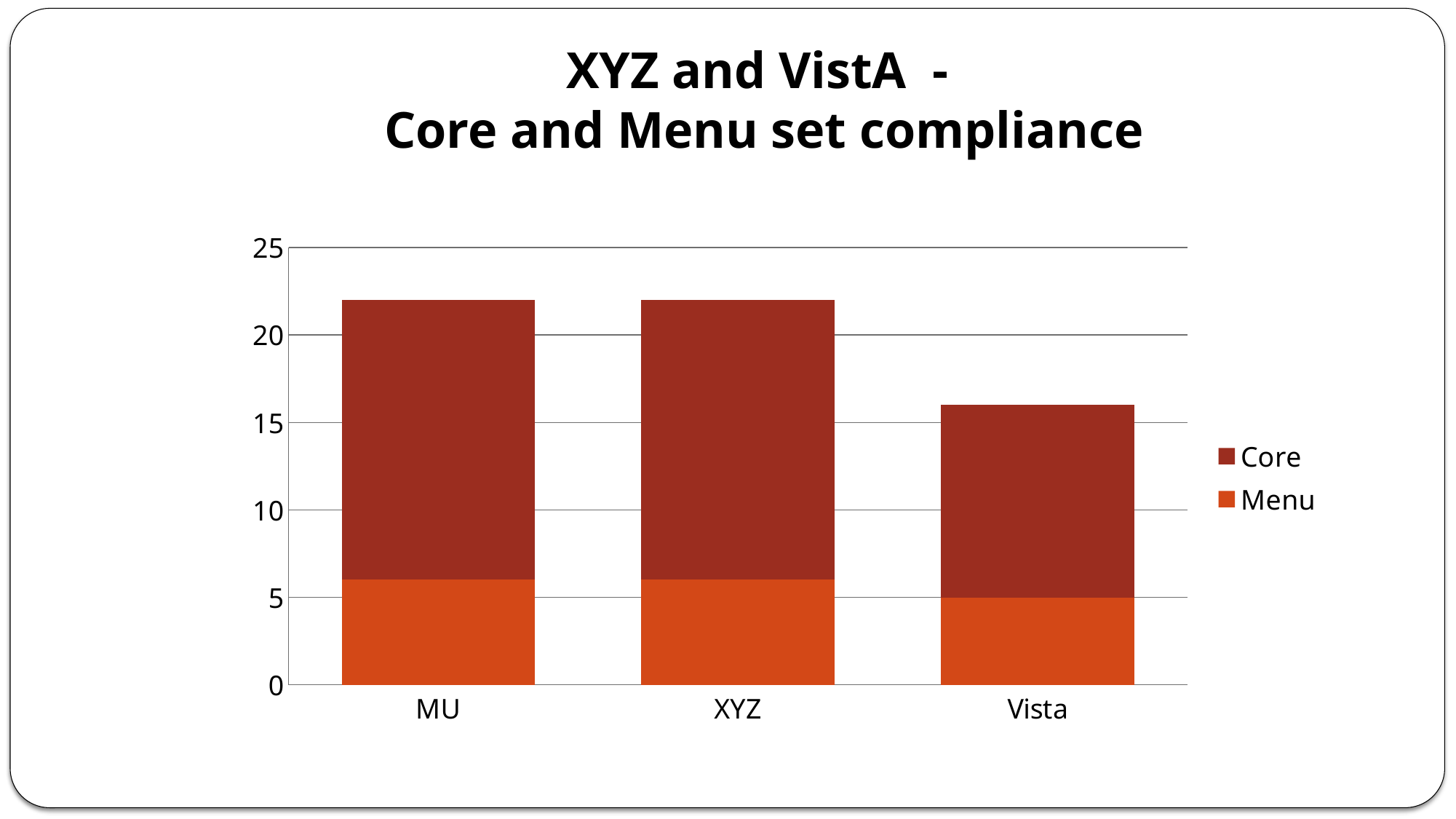
Is the Menu value for XYZ greater or less than 5? greater What is the title of the chart? XYZ and VistA - Core and Menu set compliance How many series does the legend list? 2 Is the total bar for Vista greater or less than 20? less Which is larger, the total bar for XYZ or the total bar for Vista? XYZ Is the total bar for XYZ greater or less than 25? less Which category has the lowest total bar? Vista What kind of chart is shown on the slide? stacked bar chart What is the Menu value for Vista? 5 How many categories are shown on the x axis? 3 Which series is shown in the darker red colour? Core